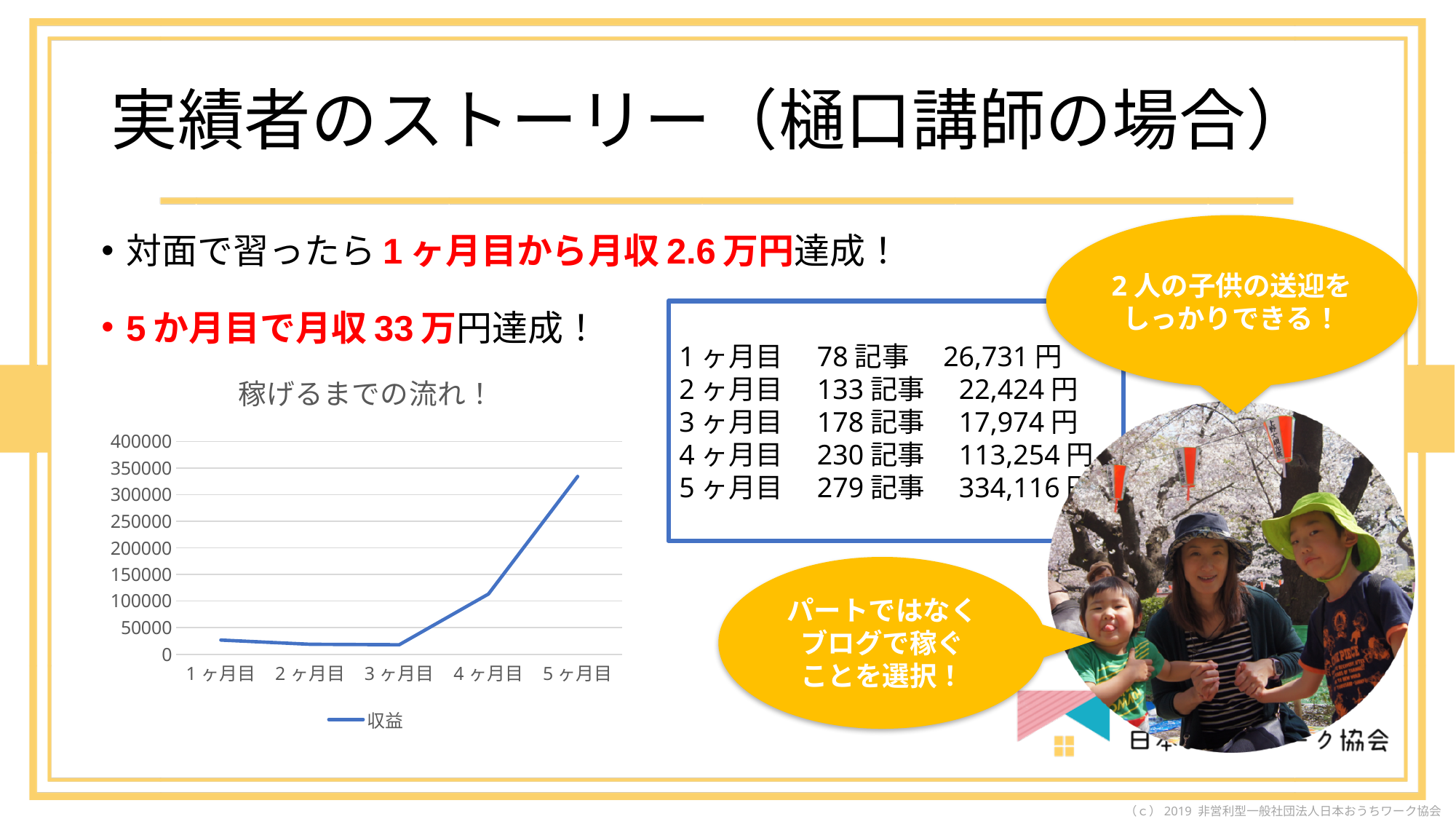
According to the table next to the chart, what is the 収益 value for 5ヶ月目? 334,116円 In the 稼げるまでの流れ！ chart, which has the larger 収益 value, 2ヶ月目 or 4ヶ月目? 4ヶ月目 In the 稼げるまでの流れ！ chart, is the value for 5ヶ月目 greater or less than 300000? greater What is the name of the series shown in the legend of the line chart? 収益 What kind of chart is shown under the heading 稼げるまでの流れ！? line chart How many months (points) are plotted along the x axis of the 稼げるまでの流れ！ chart? 5 What is the title of the line chart on the slide? 稼げるまでの流れ！ In the 稼げるまでの流れ！ chart, is the value for 1ヶ月目 greater or less than 50000? less In the 稼げるまでの流れ！ chart, does the 収益 line rise or fall from 3ヶ月目 to 5ヶ月目? rise In the 稼げるまでの流れ！ chart, is the value for 4ヶ月目 greater or less than 150000? less How many series does the legend of the 稼げるまでの流れ！ chart list? 1 Which month has the highest 収益 value in the 稼げるまでの流れ！ chart? 5ヶ月目